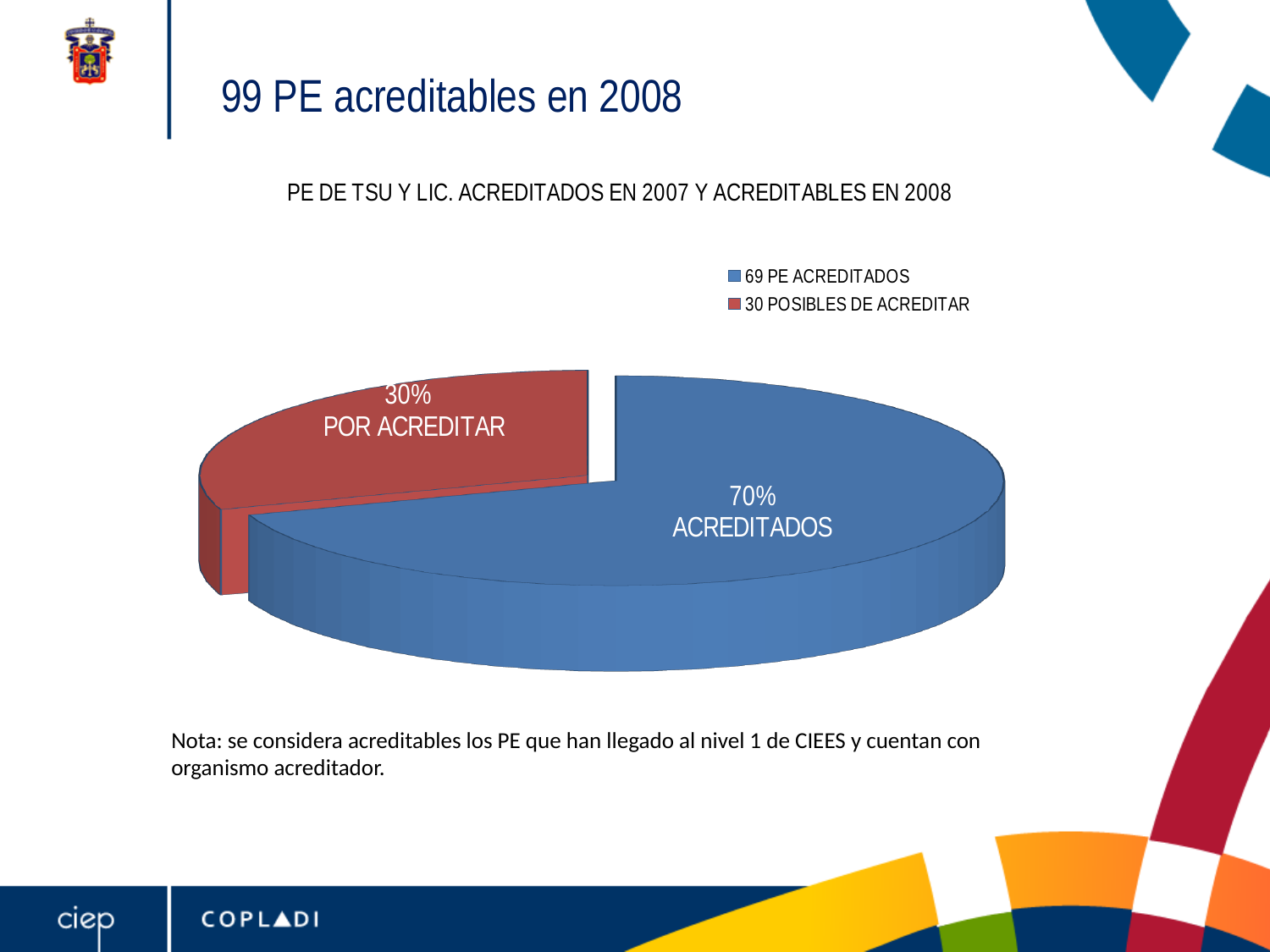
What is the difference in percentage points between the ACREDITADOS and POR ACREDITAR slices? 40 percentage points What share of the pie does the POR ACREDITAR slice represent? 30% What kind of chart is shown on the slide? pie chart How many entries does the legend list? 2 Which slice is the largest in the pie chart? ACREDITADOS According to the legend, how many PE are POSIBLES DE ACREDITAR? 30 Which slice is the smallest in the pie chart? POR ACREDITAR What share of the pie does the ACREDITADOS slice represent? 70% What colour is the ACREDITADOS slice? blue How many slices does the pie chart have? 2 What is the title of the chart? PE DE TSU Y LIC. ACREDITADOS EN 2007 Y ACREDITABLES EN 2008 Which is larger, the ACREDITADOS slice or the POR ACREDITAR slice? ACREDITADOS